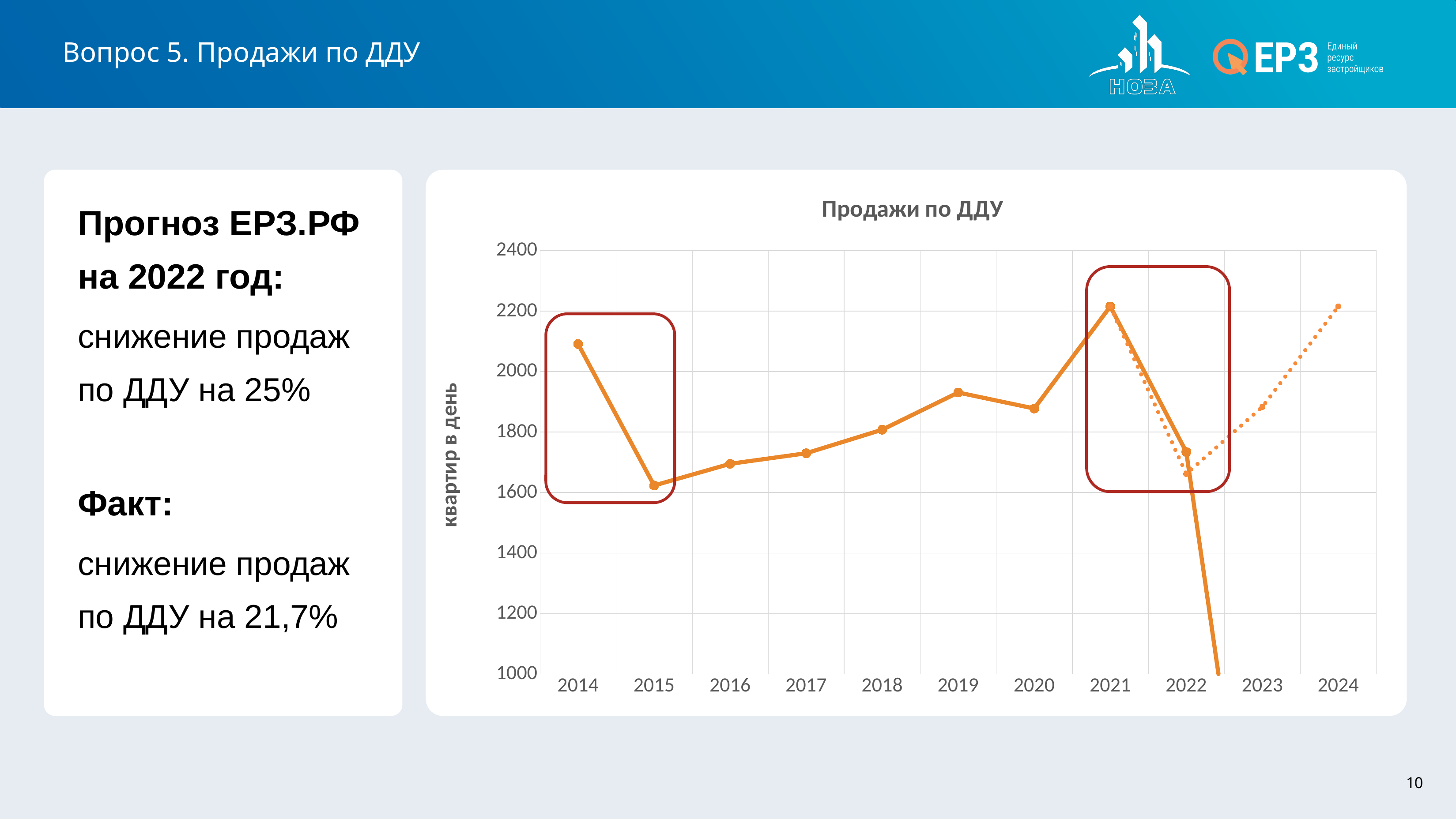
Is the value for 2017 greater or less than 1800? less What is the label of the vertical axis of the chart? квартир в день Which is larger, the value for 2019 or the value for 2020? 2019 Do the values rise or fall from 2015 to 2019? rise Which year has the lowest value on the solid line of the chart? 2015 Is the value for 2020 greater or less than 2000? less How many years are labeled on the x axis of the chart? 11 Is the value for 2022 greater or less than 1800? less Which year has the highest value on the solid line of the chart? 2021 What kind of chart is shown on the slide? line chart What is the title of the chart? Продажи по ДДУ